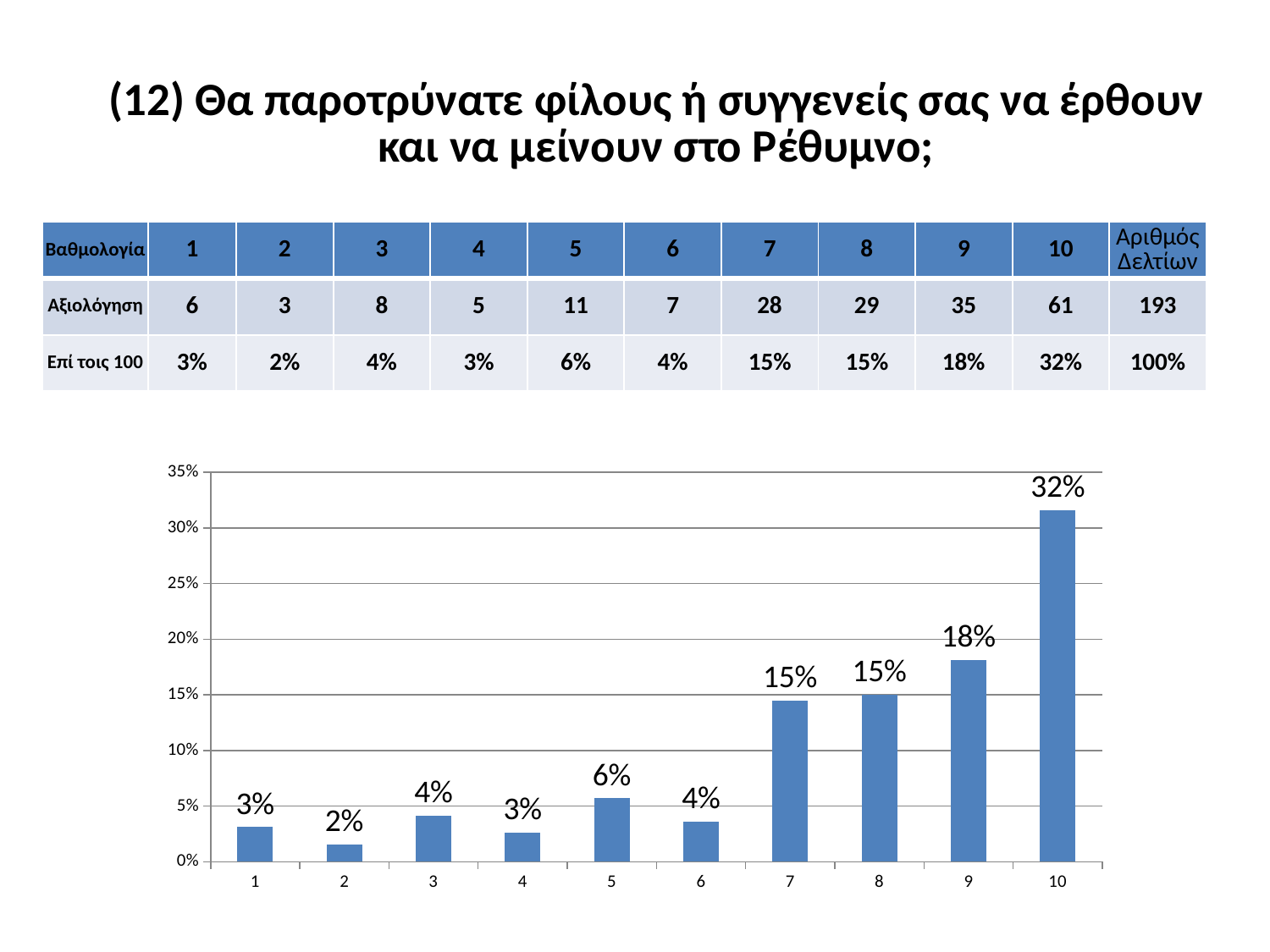
Is the value for category 7 greater or less than 10%? greater What is the value for category 5 in the bar chart? 6% What is the difference between the values for category 10 and category 9? 14 percentage points What is the difference between the values for category 5 and category 2? 4 percentage points What kind of chart is shown on the slide? Bar chart How many categories are shown on the x axis of the chart? 10 What is the value for category 9 in the bar chart? 18% What is the highest tick value shown on the y axis of the chart? 35% Which category has the lowest value in the bar chart? 2 Which category has the highest value in the bar chart? 10 Which has a larger value, category 5 or category 6? Category 5 What is the value for category 10 in the bar chart? 32%